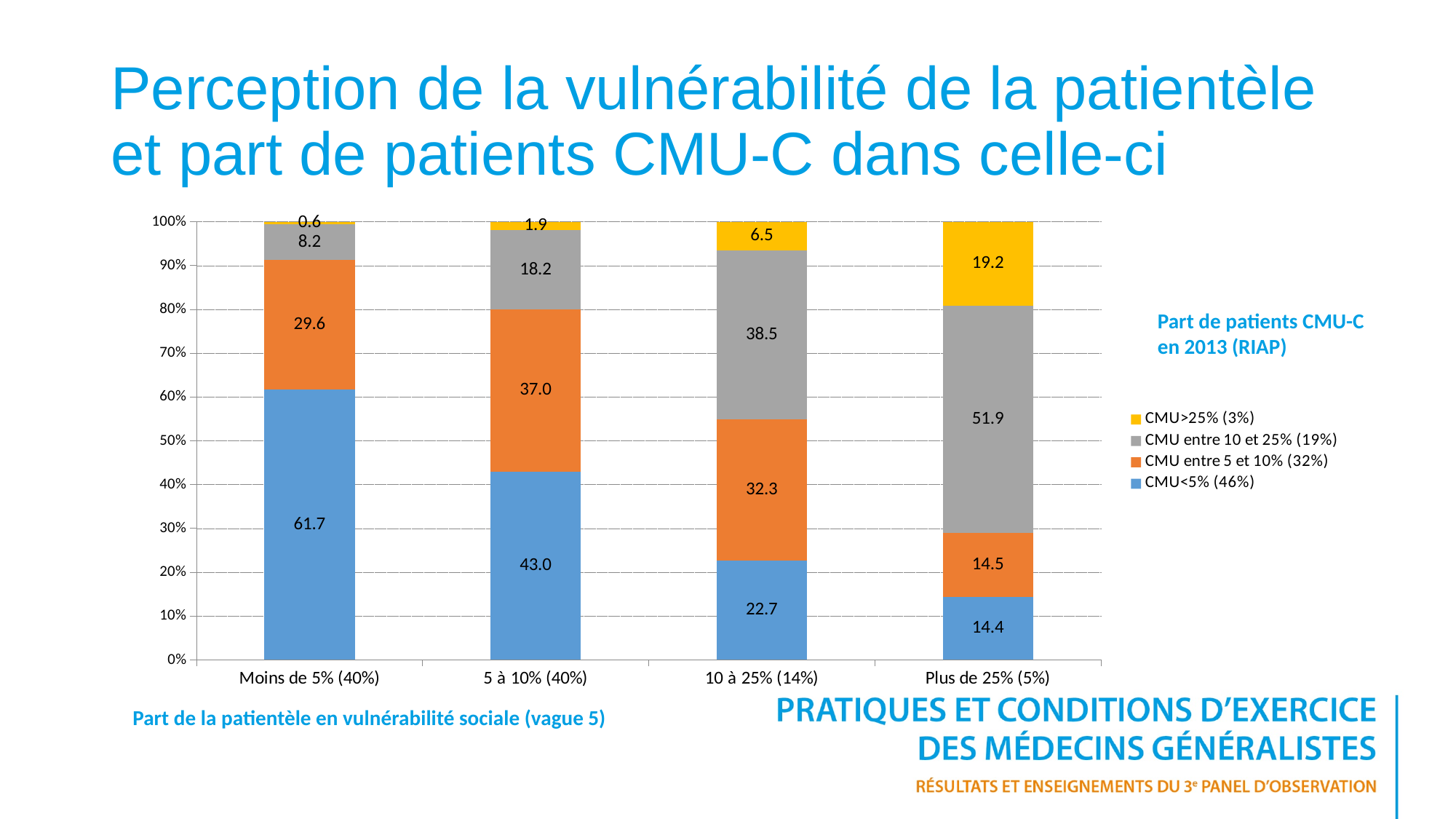
What is the value of the CMU entre 5 et 10% (32%) series for the 'Plus de 25% (5%)' category? 14.5 Does the value of the CMU<5% (46%) series rise or fall from left to right along the x axis? Fall Which category has the lowest value for the CMU>25% (3%) series? Moins de 5% (40%) How many series does the legend list? 4 What is the value of the CMU<5% (46%) series for the 'Moins de 5% (40%)' category? 61.7 How many categories are shown on the x axis of the chart? 4 For the CMU entre 10 et 25% (19%) series, which category has the larger value: '10 à 25% (14%)' or 'Plus de 25% (5%)'? Plus de 25% (5%) What is the value of the CMU entre 10 et 25% (19%) series for the '10 à 25% (14%)' category? 38.5 What is the value of the CMU>25% (3%) series for the 'Plus de 25% (5%)' category? 19.2 Which category has the highest value for the CMU<5% (46%) series? Moins de 5% (40%) What kind of chart is shown on the slide? Stacked bar chart What is the difference between the CMU entre 5 et 10% (32%) values for '5 à 10% (40%)' and 'Moins de 5% (40%)'? 7.4